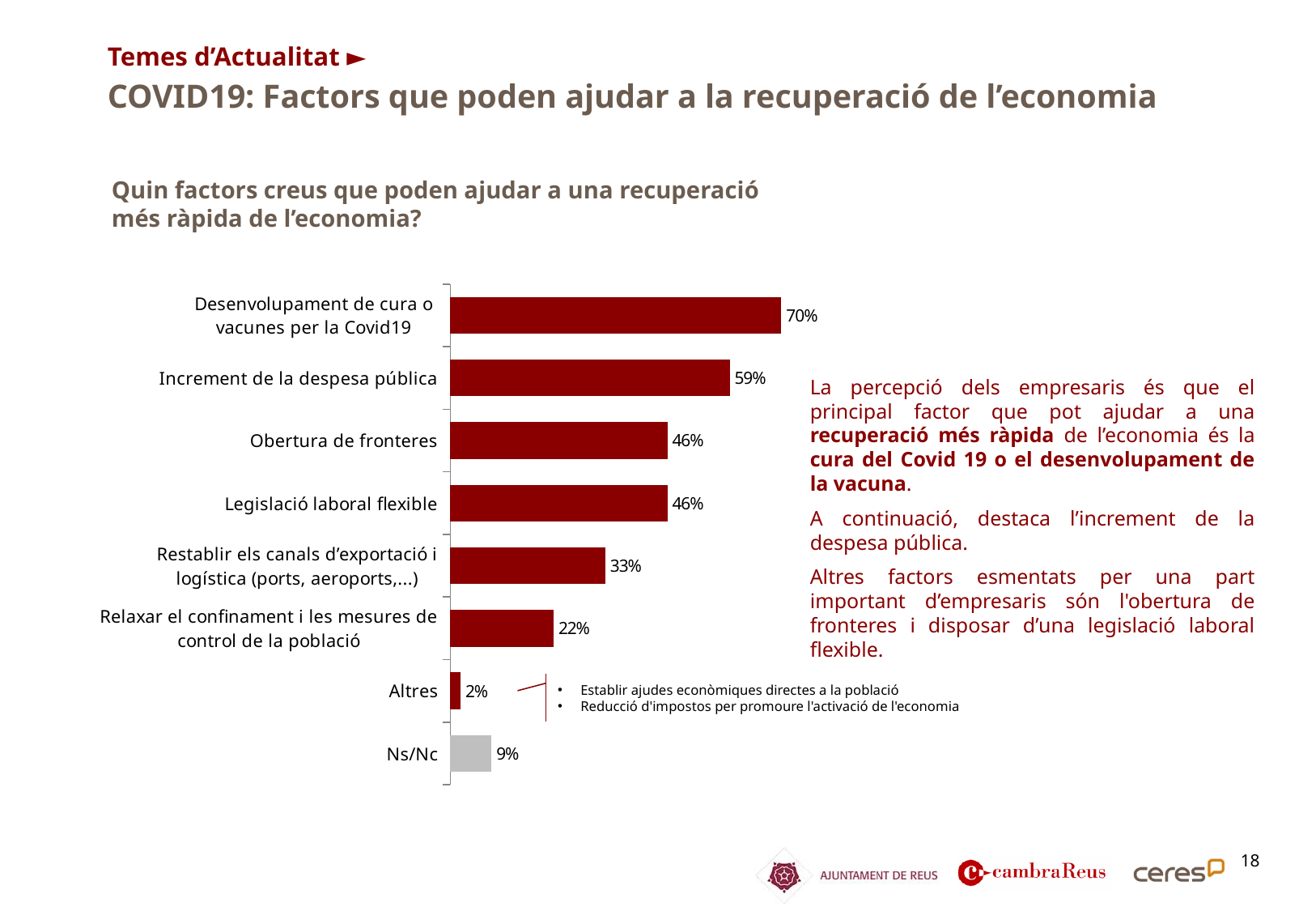
Which category has the lowest value? Altres Which category's bar is shown in grey rather than dark red? Ns/Nc Which is larger, the value for "Restablir els canals d'exportació i logística (ports, aeroports,...)" or the value for "Relaxar el confinament i les mesures de control de la població"? Restablir els canals d'exportació i logística (ports, aeroports,...) How many categories are shown in the chart? 8 Which category has the highest value? Desenvolupament de cura o vacunes per la Covid19 What kind of chart is shown on the slide? Bar chart What is the difference between the values for "Obertura de fronteres" and "Relaxar el confinament i les mesures de control de la població"? 24% What is the value for "Restablir els canals d'exportació i logística (ports, aeroports,...)"? 33% What is the value for "Ns/Nc"? 9% What is the difference between the values for "Desenvolupament de cura o vacunes per la Covid19" and "Increment de la despesa pública"? 11% What is the value for "Desenvolupament de cura o vacunes per la Covid19"? 70% What is the value for "Increment de la despesa pública"? 59%